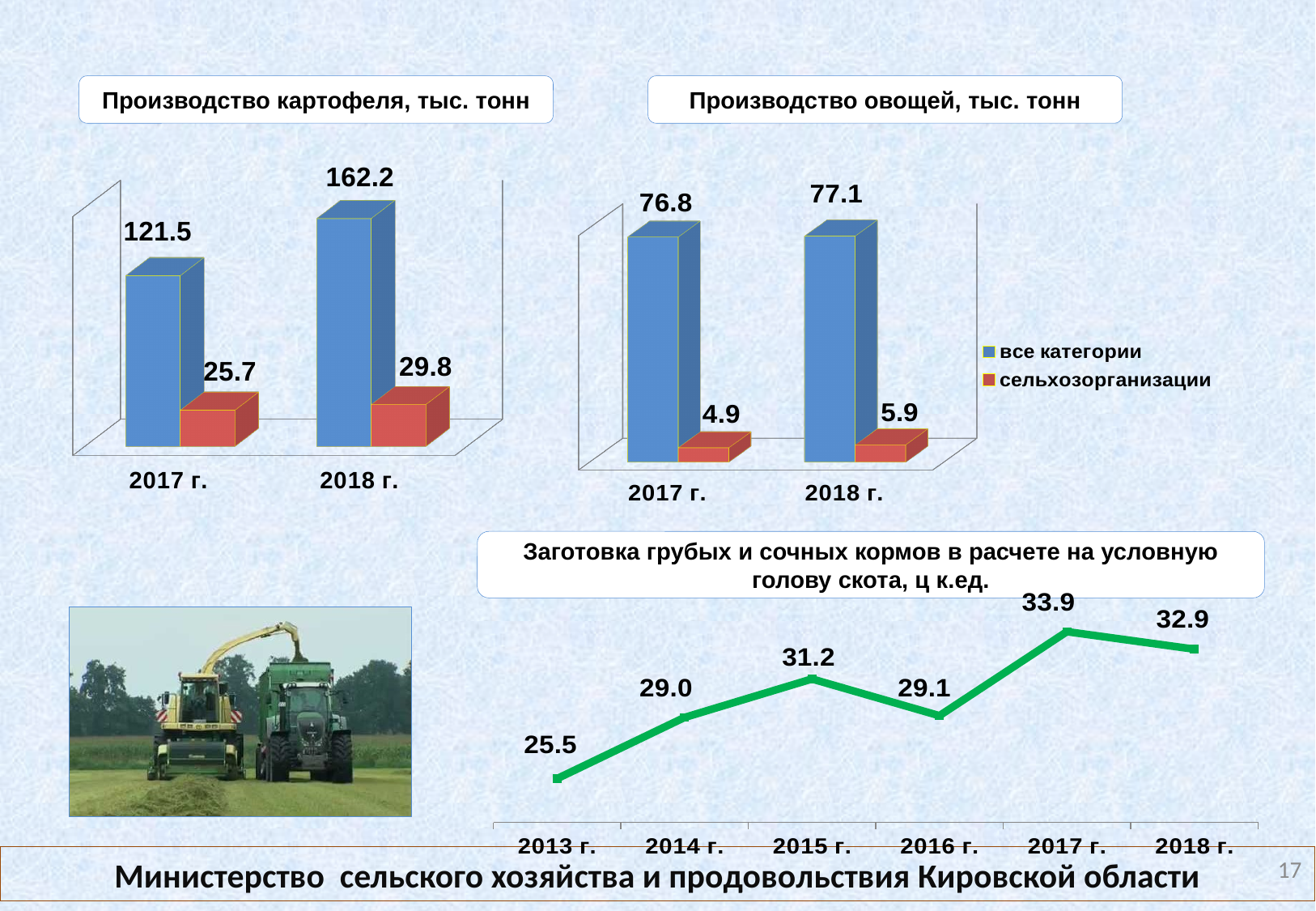
In the chart 'Заготовка грубых и сочных кормов в расчете на условную голову скота, ц к.ед.', what is the value for 2015 г.? 31.2 In the chart 'Производство картофеля, тыс. тонн', what is the value for 'сельхозорганизации' in 2017 г.? 25.7 In the chart 'Производство овощей, тыс. тонн', what is the difference between the 'все категории' and 'сельхозорганизации' values in 2018 г.? 71.2 In the chart 'Заготовка грубых и сочных кормов в расчете на условную голову скота, ц к.ед.', which year has the highest value? 2017 г. In the chart 'Производство картофеля, тыс. тонн', by how much did the 'все категории' value change from 2017 г. to 2018 г.? 40.7 How many years are plotted in the chart 'Заготовка грубых и сочных кормов в расчете на условную голову скота, ц к.ед.'? 6 What kind of chart is 'Производство картофеля, тыс. тонн'? Bar chart In the chart 'Заготовка грубых и сочных кормов в расчете на условную голову скота, ц к.ед.', which year has the lowest value? 2013 г. In the chart 'Производство овощей, тыс. тонн', what is the value for 'сельхозорганизации' in 2018 г.? 5.9 How many series does the legend of the chart 'Производство овощей, тыс. тонн' list? 2 In the chart 'Производство овощей, тыс. тонн', what is the value for 'все категории' in 2017 г.? 76.8 In the chart 'Производство картофеля, тыс. тонн', what is the value for 'все категории' in 2018 г.? 162.2